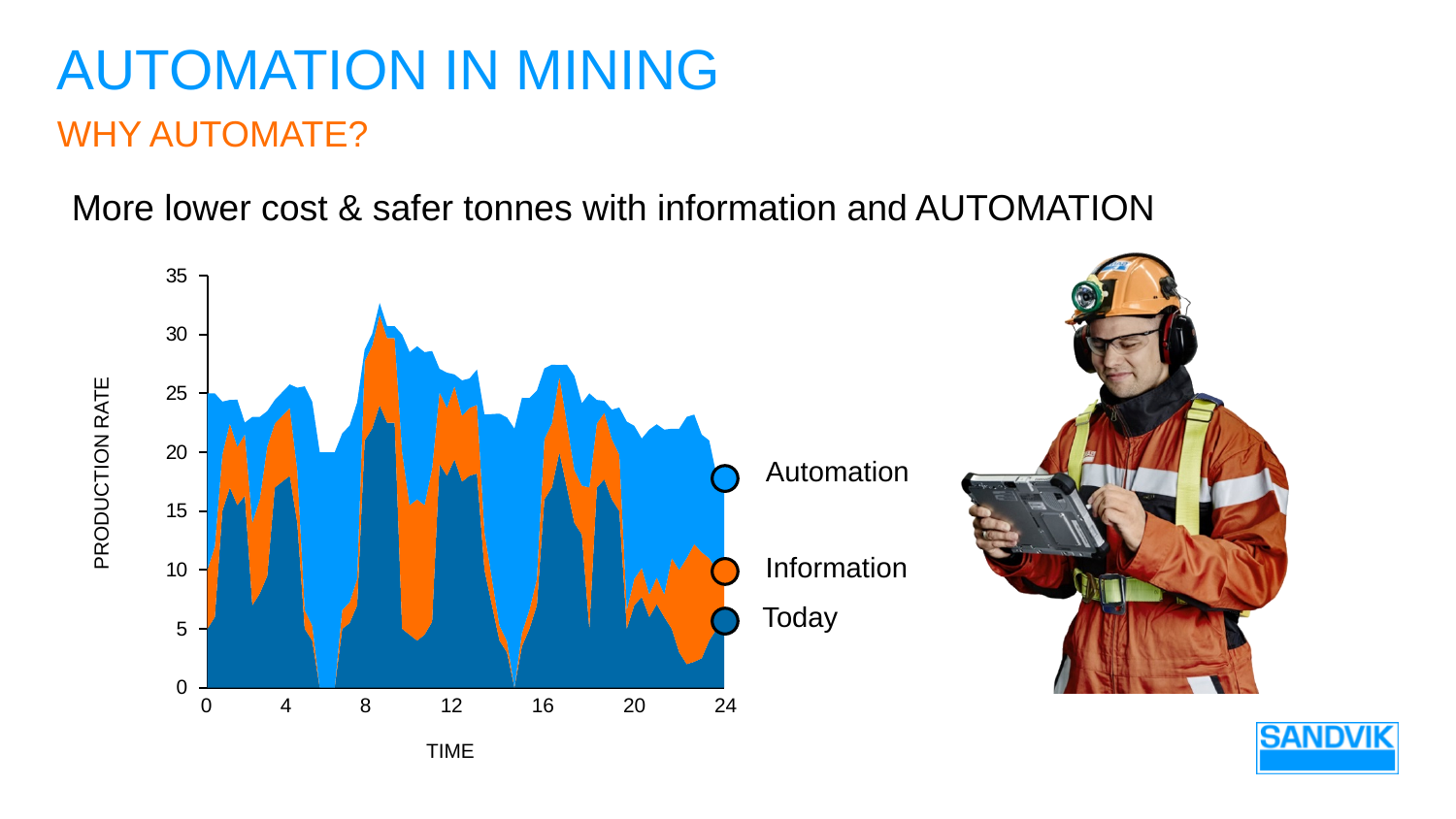
What are the titles of the x axis and y axis of the chart? TIME (x axis) and PRODUCTION RATE (y axis) Is the peak of the Automation area, around time 8 to 9, greater or less than 30? greater Which is higher: the top of the Automation area at time 8 or at time 24? Time 8 Is the Today value at time 6 greater or less than 5? less How many tick labels are shown on the x axis of the chart? 7 Does the Today series rise or fall between time 20 and time 24? Fall Is the Today value at time 17 greater or less than 10? greater What kind of chart is shown on the slide? Area chart How many series does the chart's legend list? 3 What are the three series named in the chart's legend? Automation, Information, Today